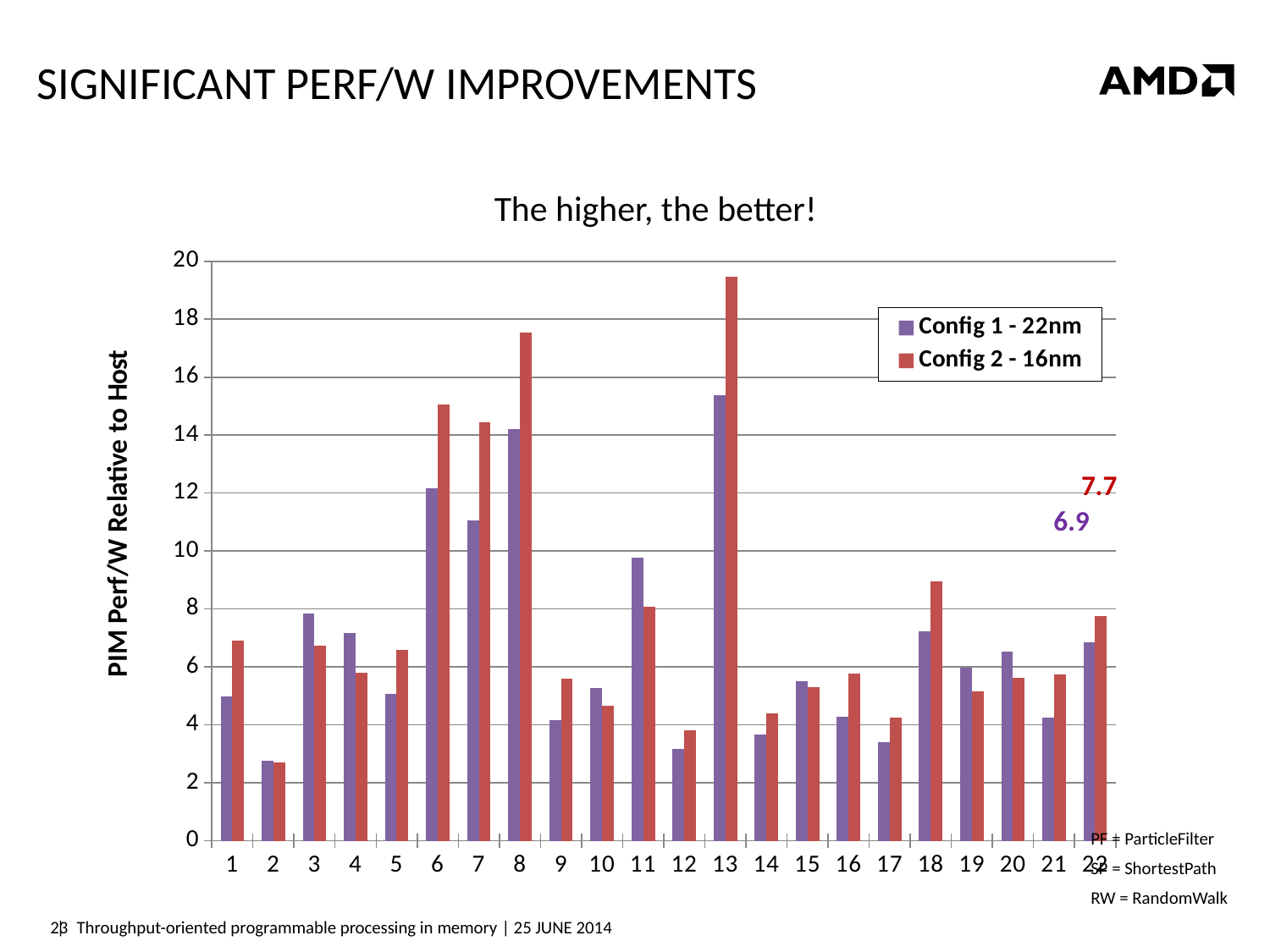
Is the value for Config 2 - 16nm at category 13 greater or less than 18? greater Which category has the highest value for Config 2 - 16nm? 13 What kind of chart is shown on the slide? bar chart Which category has the lowest value for Config 2 - 16nm? 2 Is the value for Config 2 - 16nm at category 8 greater or less than 16? greater How many series does the legend list? 2 At category 1, which series has the larger value? Config 2 - 16nm What is the label of the y axis? PIM Perf/W Relative to Host Which category has the highest value for Config 1 - 22nm? 13 At category 3, which series has the larger value? Config 1 - 22nm How many categories are shown along the x axis? 22 Is the value for Config 1 - 22nm at category 17 greater or less than 4? less